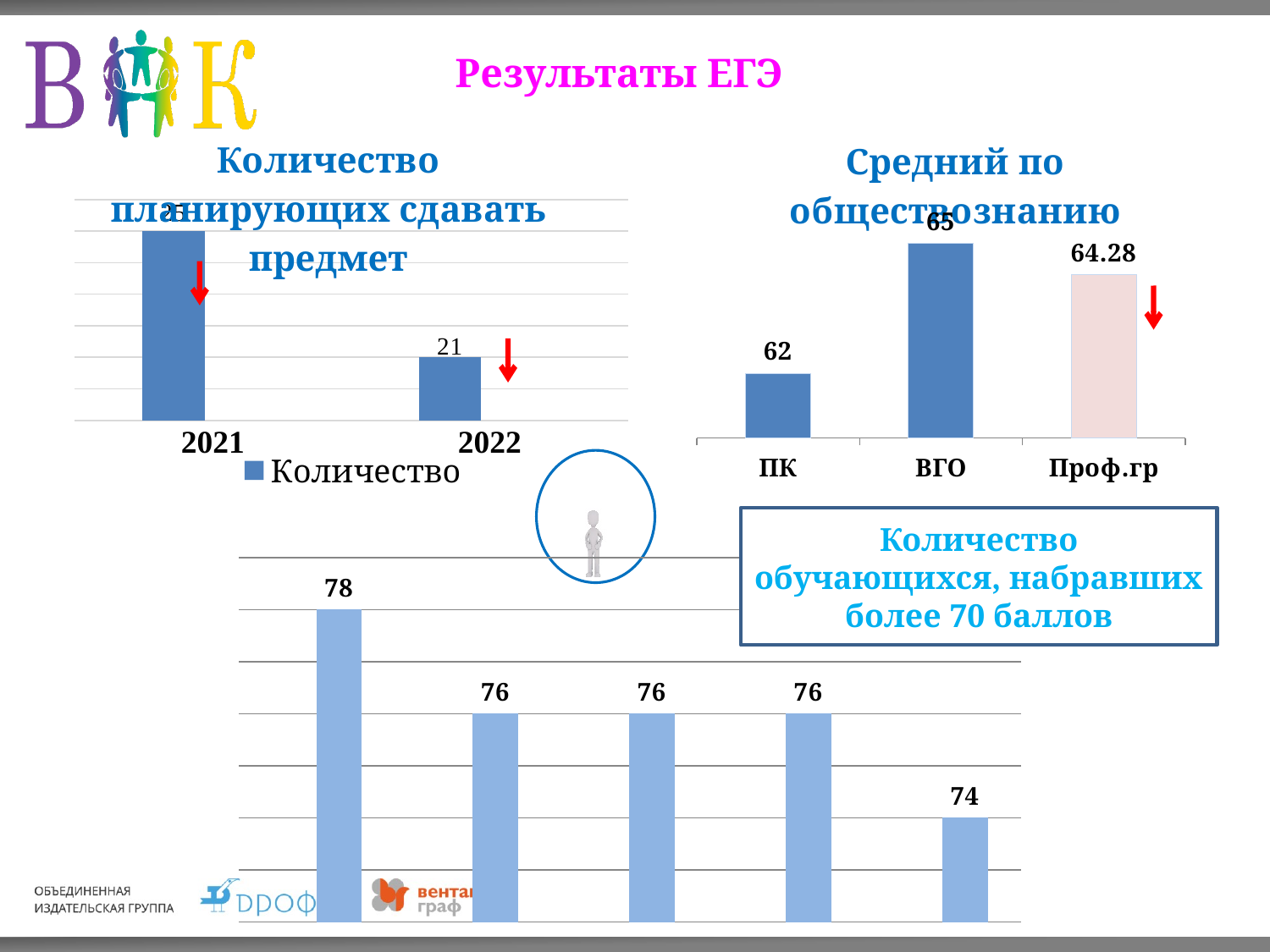
In the chart 'Количество планирующих сдавать предмет', what series name does the legend show? Количество In the chart 'Средний по обществознанию', which category has the highest value? ВГО In the chart 'Средний по обществознанию', how many categories are shown? 3 In the bottom chart 'Количество обучающихся, набравших более 70 баллов', how many bars are shown? 5 In the chart 'Средний по обществознанию', what is the difference between the values for ВГО and ПК? 3 In the bottom chart 'Количество обучающихся, набравших более 70 баллов', what is the value of the first (leftmost) bar? 78 In the chart 'Средний по обществознанию', what is the value for Проф.гр? 64.28 In the chart 'Средний по обществознанию', what is the value for ВГО? 65 In the chart 'Количество планирующих сдавать предмет', what is the value for 2022? 21 In the chart 'Средний по обществознанию', which category has the lowest value? ПК In the chart 'Средний по обществознанию', what is the value for ПК? 62 In the chart 'Количество планирующих сдавать предмет', which year has the larger value, 2021 or 2022? 2021